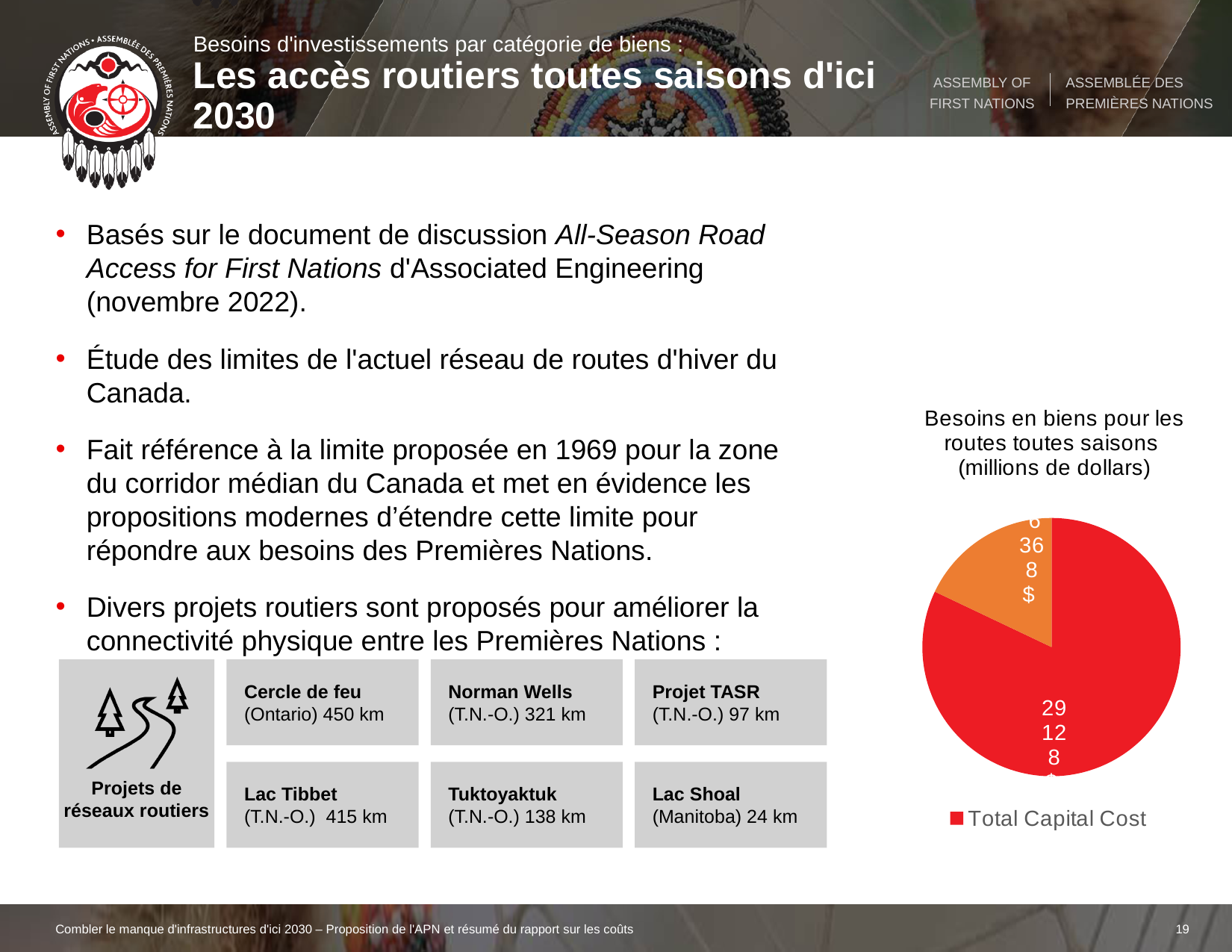
Which colour is the smallest slice of the pie chart? Orange In what unit are the values of the pie chart expressed, according to its title? Millions de dollars How many entries does the legend of the pie chart list? 1 Does the red slice of the pie chart represent more or less than half of the pie? More Which slice of the pie chart is larger, the red slice or the orange slice? The red slice Which colour is the largest slice of the pie chart? Red What is the title of the pie chart? Besoins en biens pour les routes toutes saisons (millions de dollars) What kind of chart is shown on the right side of the slide? Pie chart How many slices does the pie chart have? 2 What is the legend entry shown below the pie chart? Total Capital Cost